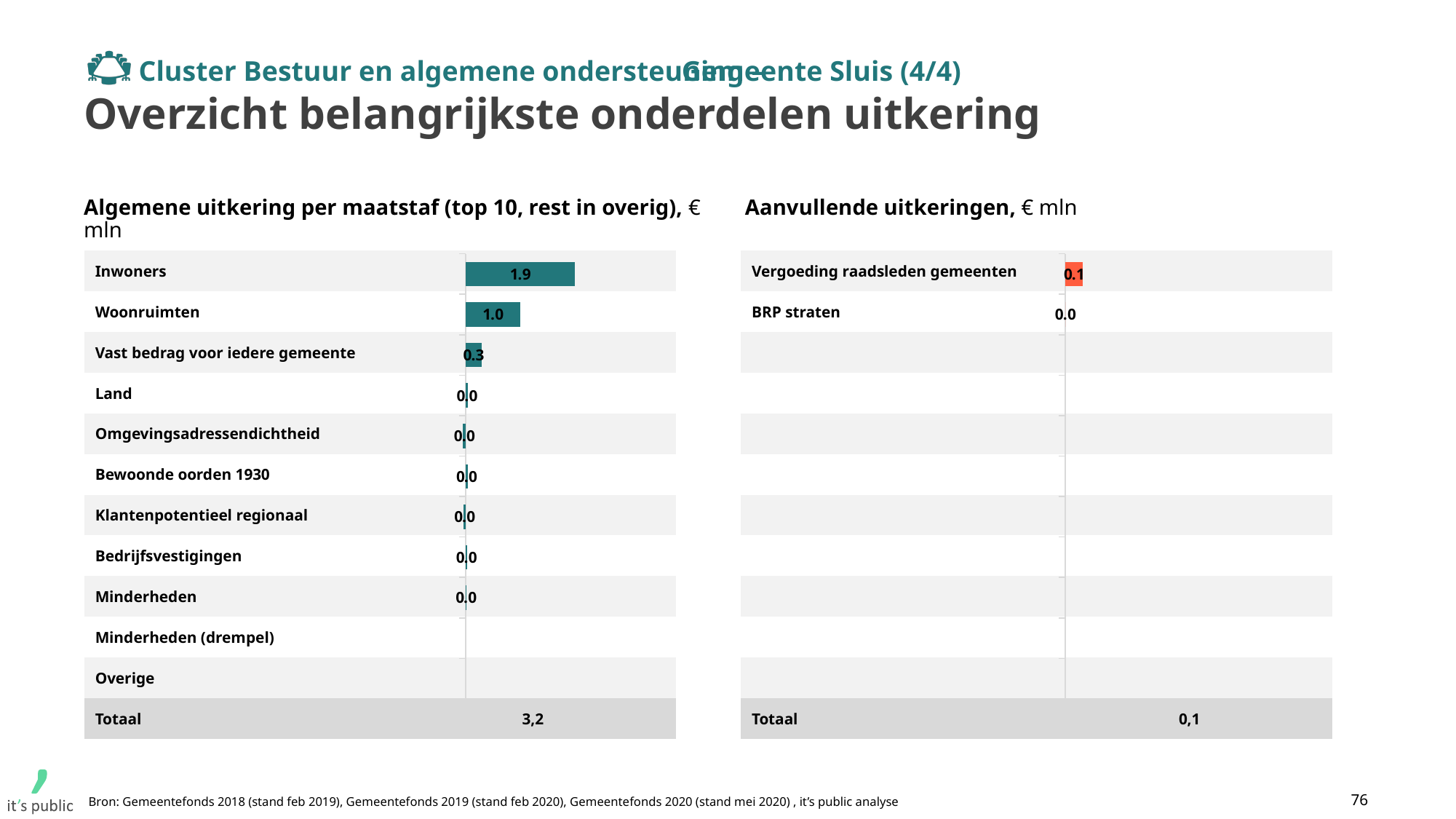
In the chart 'Algemene uitkering per maatstaf', which is larger: Woonruimten or Vast bedrag voor iedere gemeente? Woonruimten In the chart 'Algemene uitkering per maatstaf', what is the difference between the values for Inwoners and Woonruimten? 0.9 What kind of chart is the 'Algemene uitkering per maatstaf' chart on the left? Bar chart In the chart 'Aanvullende uitkeringen', how many categories are plotted (excluding Totaal)? 2 In the chart 'Algemene uitkering per maatstaf', what is the value for Woonruimten? 1.0 In the chart 'Aanvullende uitkeringen', what is the value for Vergoeding raadsleden gemeenten? 0.1 In the chart 'Algemene uitkering per maatstaf', what is the value for Inwoners? 1.9 In the chart 'Algemene uitkering per maatstaf', what is the value for Vast bedrag voor iedere gemeente? 0.3 In the chart 'Algemene uitkering per maatstaf', what is the Totaal shown at the bottom? 3,2 In the chart 'Aanvullende uitkeringen', what is the Totaal shown at the bottom? 0,1 In the chart 'Algemene uitkering per maatstaf', which category has the highest value? Inwoners In the chart 'Aanvullende uitkeringen', what is the value for BRP straten? 0.0